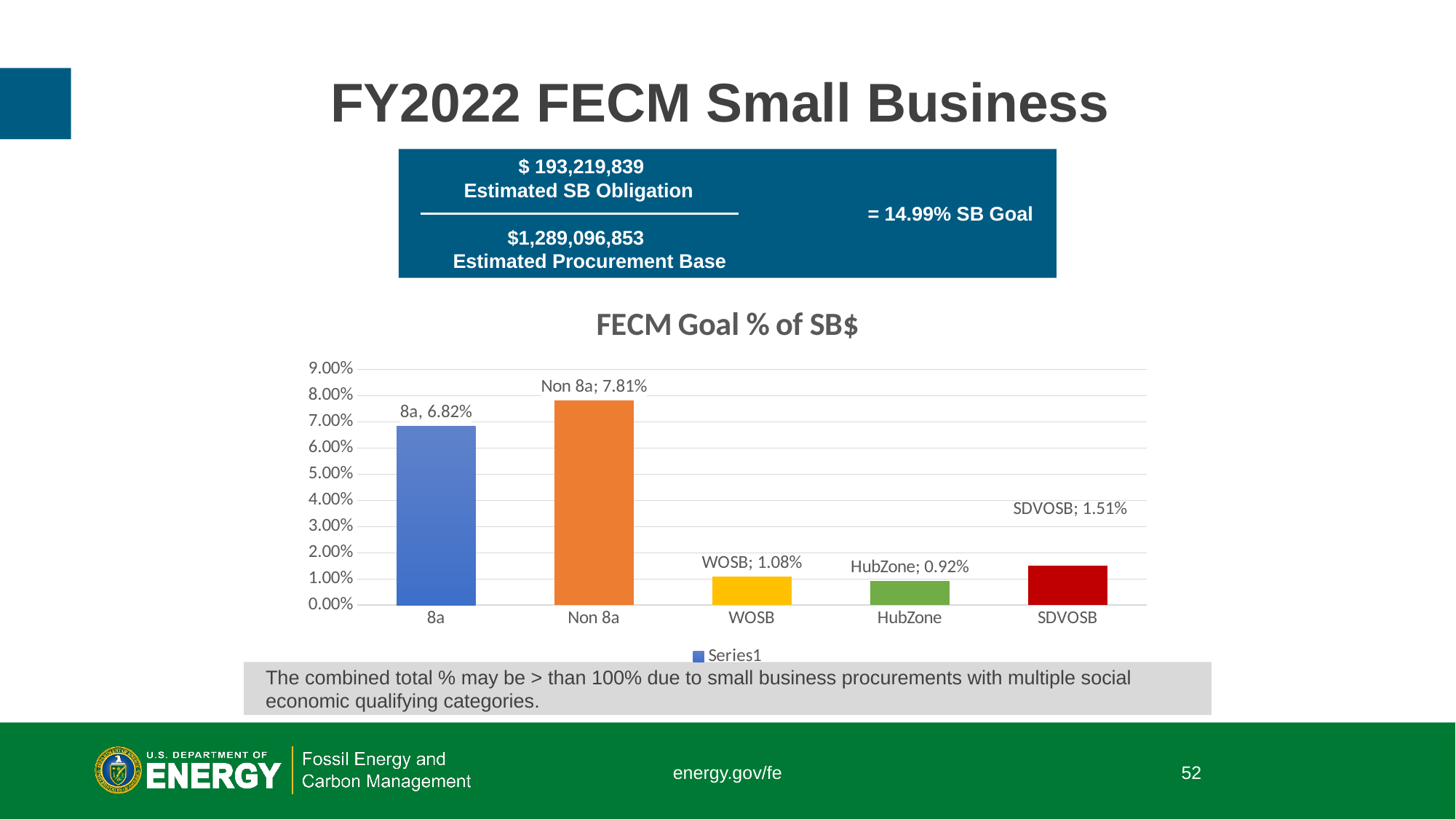
What is the title of the chart on the slide? FECM Goal % of SB$ Is the value for 8a in the FECM Goal % of SB$ chart greater or less than 5.00%? greater Which category has the highest value in the FECM Goal % of SB$ chart? Non 8a How many categories are shown in the FECM Goal % of SB$ chart? 5 What is the value for Non 8a in the FECM Goal % of SB$ chart? 7.81% What is the difference between the Non 8a and 8a values in the FECM Goal % of SB$ chart? 0.99% Which category has the lowest value in the FECM Goal % of SB$ chart? HubZone What type of chart is the FECM Goal % of SB$ chart? bar chart What is the value for HubZone in the FECM Goal % of SB$ chart? 0.92% What is the value for WOSB in the FECM Goal % of SB$ chart? 1.08% Which is larger in the FECM Goal % of SB$ chart, SDVOSB or WOSB? SDVOSB What is the value for SDVOSB in the FECM Goal % of SB$ chart? 1.51%